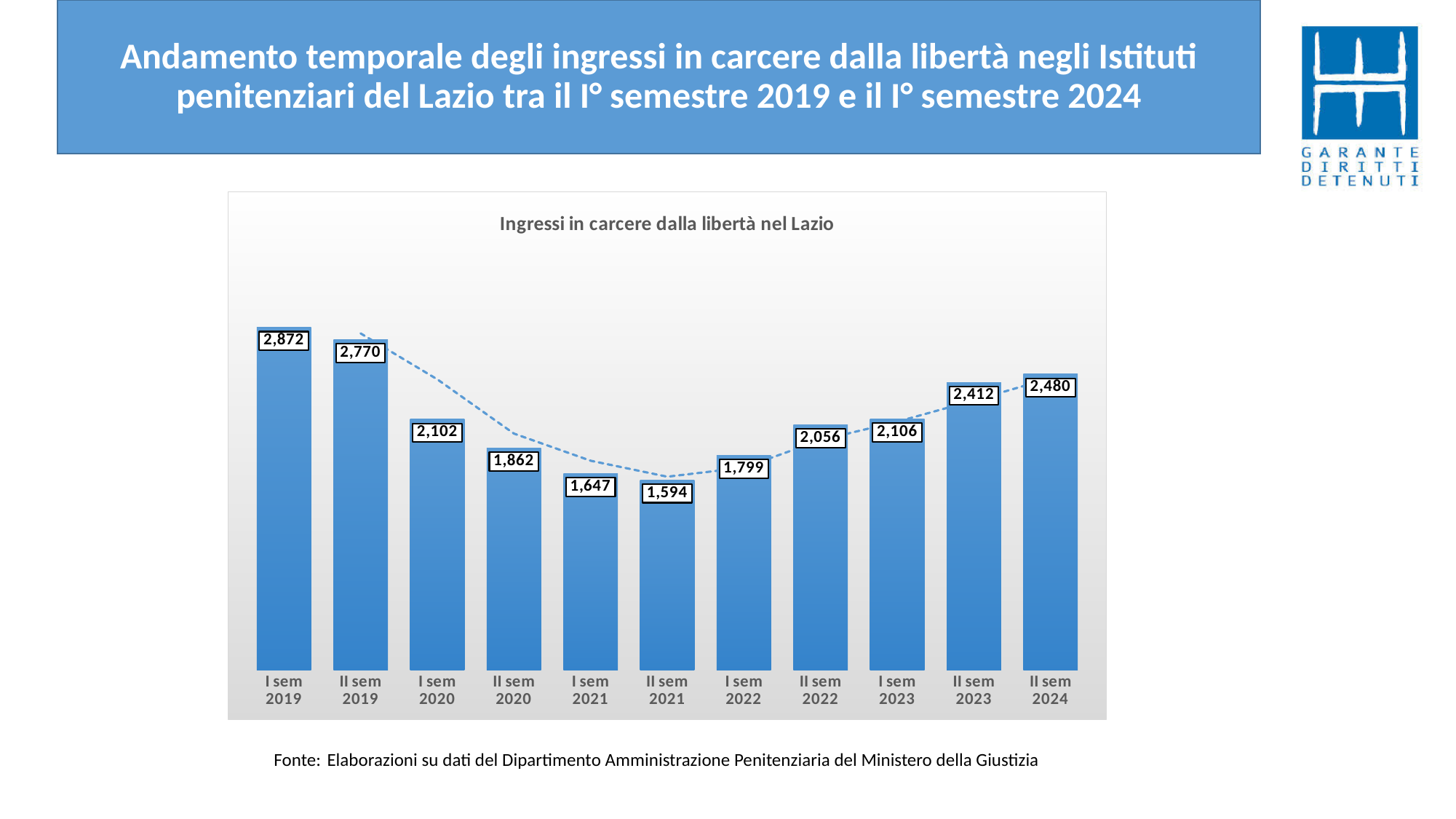
What is the value for II sem 2024? 2,480 Which period has the lowest value? II sem 2021 What is the value for I sem 2019? 2,872 How many bars are shown in the chart? 11 What is the title of the chart? Ingressi in carcere dalla libertà nel Lazio What is the difference between the values for II sem 2024 and II sem 2023? 68 Which is larger, the value for I sem 2020 or the value for I sem 2023? I sem 2023 What is the difference between the values for I sem 2019 and II sem 2019? 102 What kind of chart is shown on the slide? Bar chart Which period has the highest value? I sem 2019 Do the values rise or fall from I sem 2019 to II sem 2021? Fall What is the value for II sem 2021? 1,594